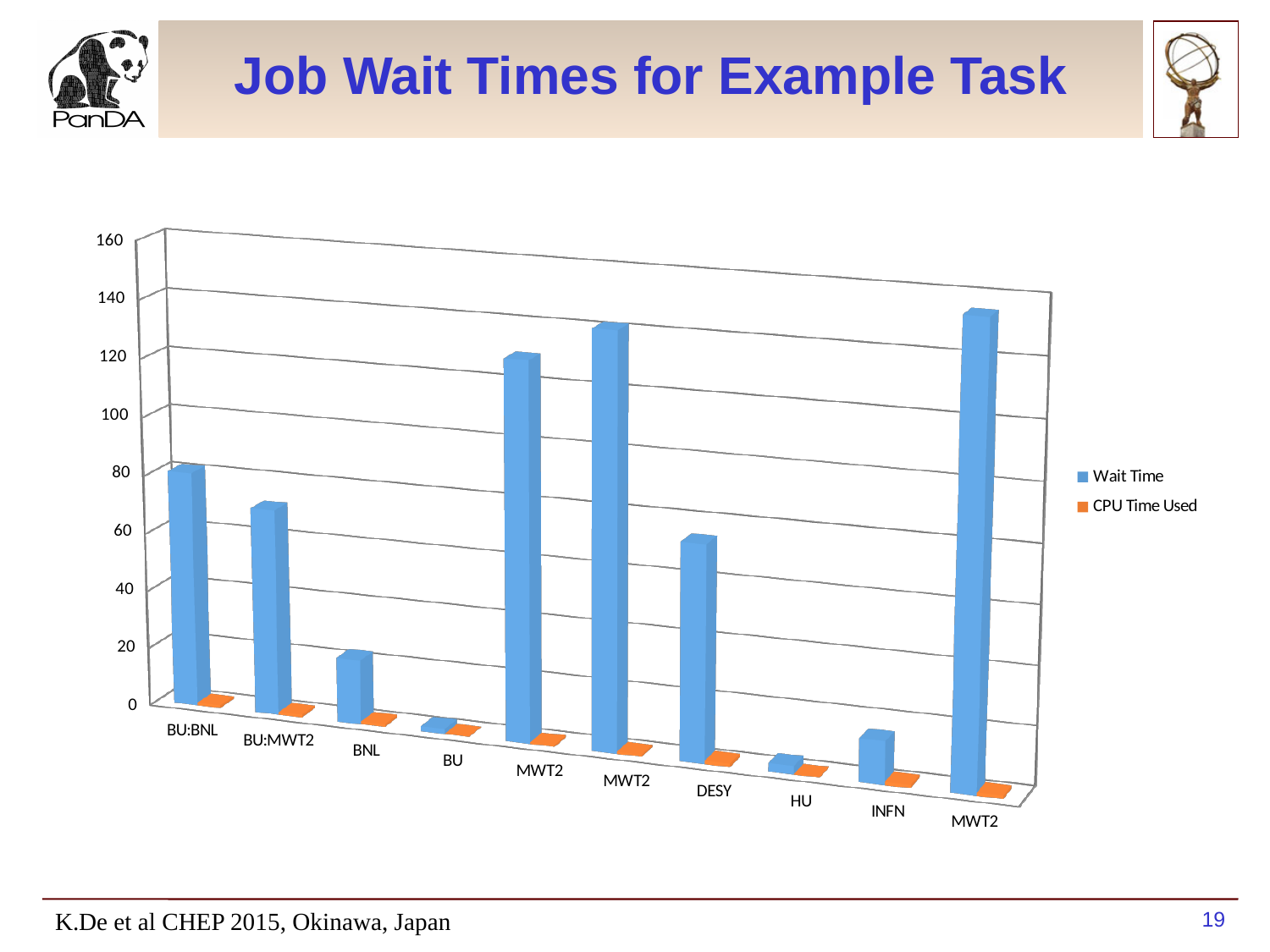
How many series does the legend list? 2 Is the Wait Time value for INFN greater or less than 40? less What is the title of the slide containing the chart? Job Wait Times for Example Task How many categories are shown along the x axis? 10 Is the Wait Time value for DESY greater or less than 40? greater Is the Wait Time value for BU:BNL greater or less than 60? greater Which has the larger Wait Time, BU:BNL or BU:MWT2? BU:BNL What kind of chart is shown on the slide? bar chart Which series is shown in blue? Wait Time Which has the larger Wait Time, BNL or BU? BNL